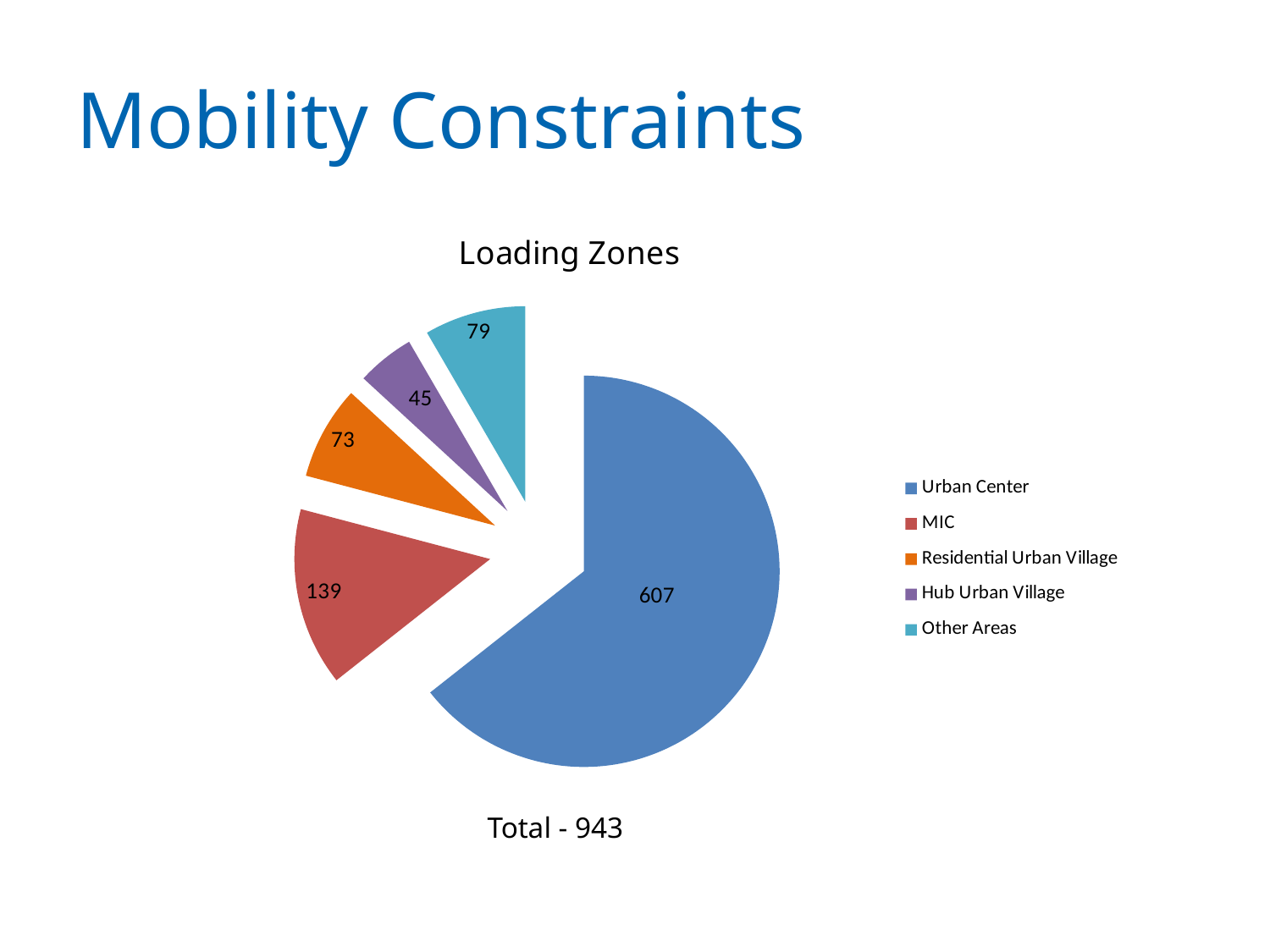
What kind of chart is shown on the slide? Pie chart Which category has the smallest slice in the Loading Zones pie chart? Hub Urban Village What is the value for Residential Urban Village in the Loading Zones pie chart? 73 Which category has the largest slice in the Loading Zones pie chart? Urban Center What is the difference between the Urban Center and MIC values in the Loading Zones pie chart? 468 What is the value for Other Areas in the Loading Zones pie chart? 79 What total is stated below the Loading Zones pie chart? Total - 943 Which is larger in the Loading Zones pie chart, Other Areas or Residential Urban Village? Other Areas What is the value for Hub Urban Village in the Loading Zones pie chart? 45 What is the value for MIC in the Loading Zones pie chart? 139 What is the value for Urban Center in the Loading Zones pie chart? 607 How many categories are shown in the Loading Zones pie chart? 5